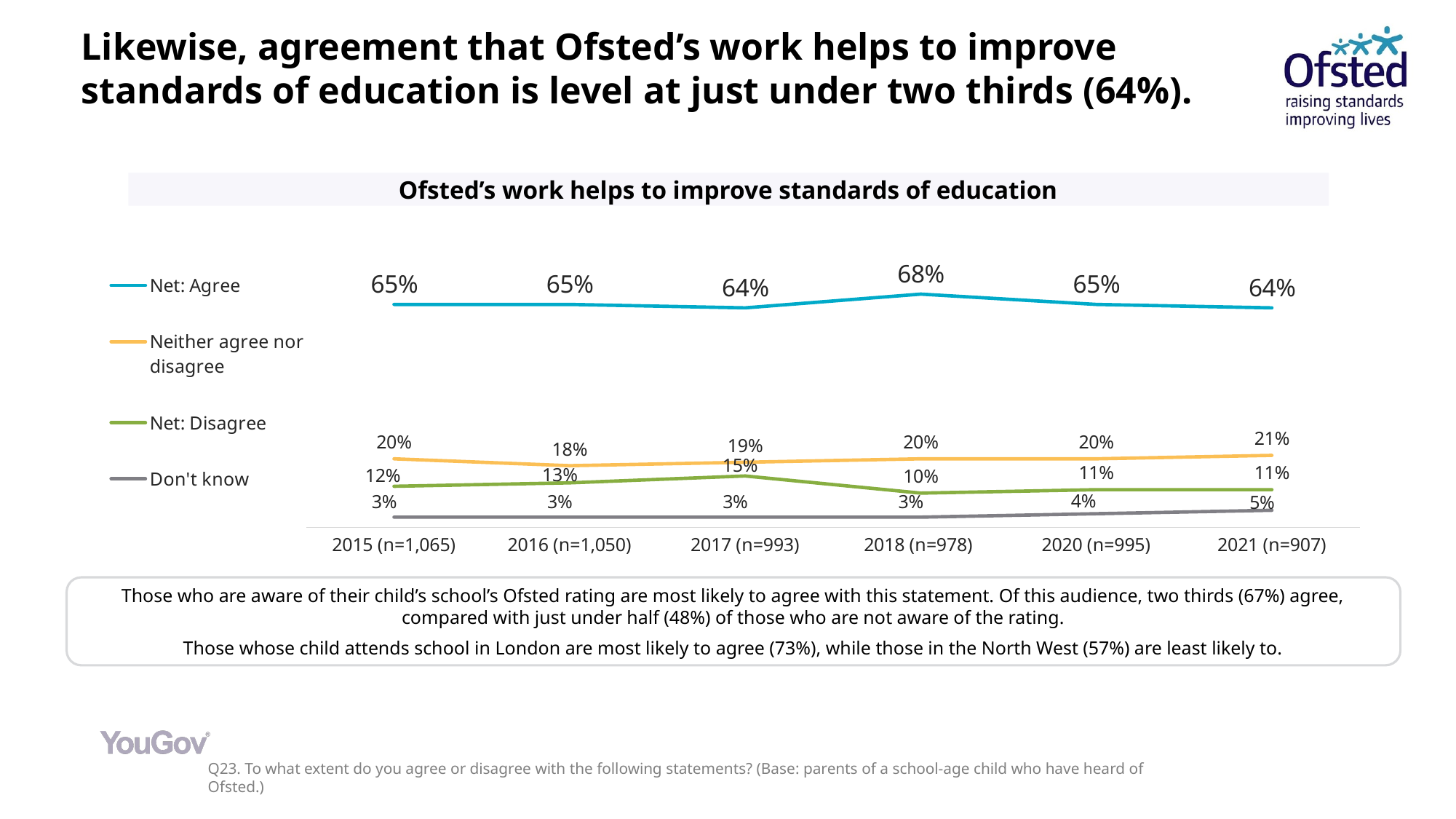
What kind of chart is shown? Line chart What is the Net: Agree value for 2018 (n=978)? 68% Which is larger in 2017 (n=993): Neither agree nor disagree or Net: Disagree? Neither agree nor disagree How many time points are plotted on the x axis? 6 What is the Neither agree nor disagree value for 2016 (n=1,050)? 18% In which year is Net: Disagree lowest? 2018 (n=978) In which year is Net: Agree highest? 2018 (n=978) Does the Don't know series rise or fall from 2015 to 2021? Rise What is the Net: Disagree value for 2017 (n=993)? 15% What is the difference between Net: Agree and Net: Disagree in 2021 (n=907)? 53 percentage points What is the Don't know value for 2021 (n=907)? 5% How many series does the legend list? 4